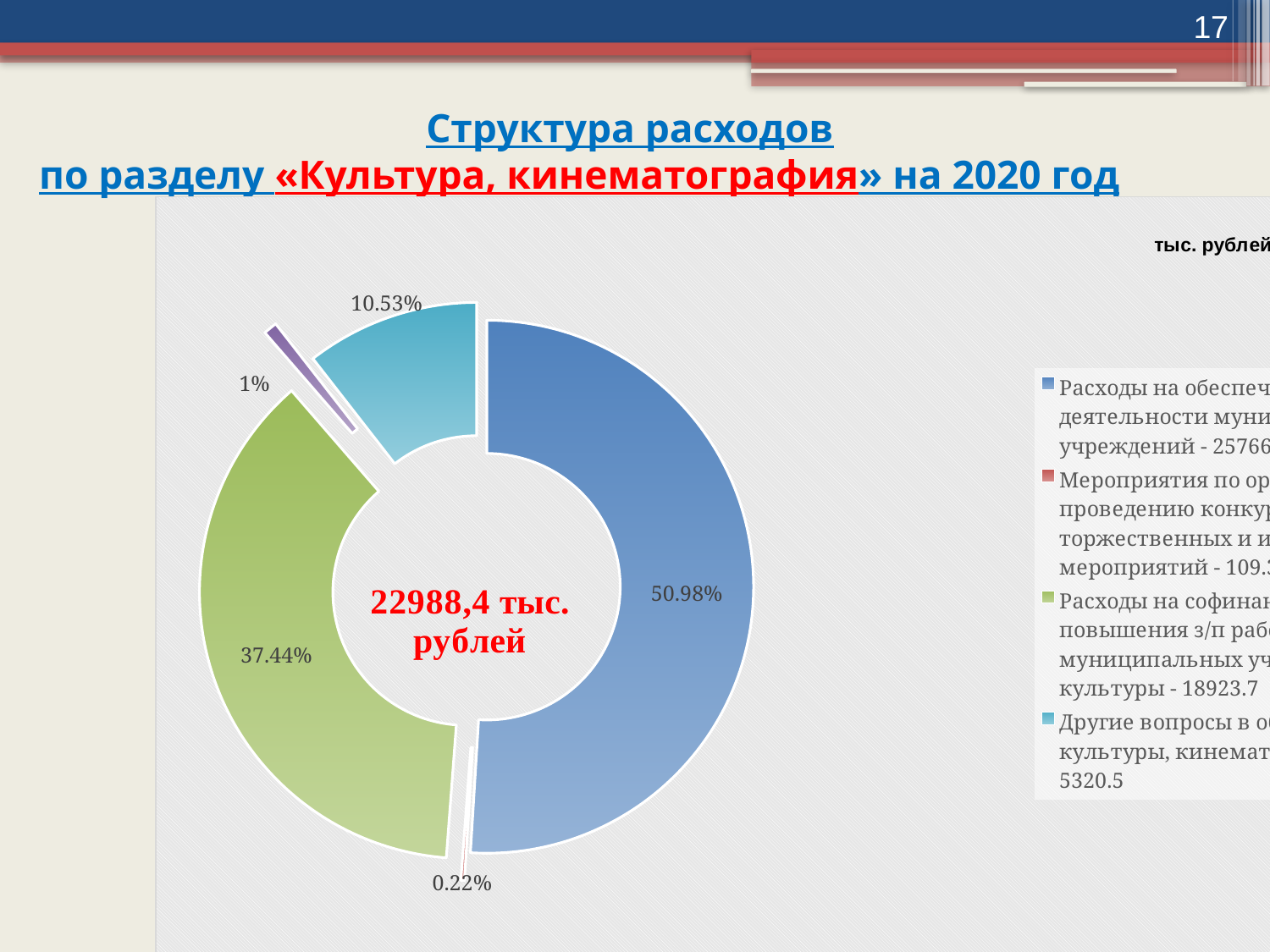
What kind of chart is shown on the slide? doughnut (pie) chart Which slice is larger, the green one or the light blue (teal) one? the green one (37.44%) What total amount is written in the centre of the doughnut chart? 22988,4 тыс. рублей What percentage is shown for the smallest slice of the doughnut chart? 0.22% What year does the slide title say the expenditure structure is for? 2020 What percentage is shown for the largest slice of the doughnut chart? 50.98% What percentage is shown for the purple slice of the chart? 1% What is the difference in percentage points between the 37.44% slice and the 10.53% slice? 26.91 What is the difference in percentage points between the 50.98% slice and the 37.44% slice? 13.54 How many slices with percentage labels does the doughnut chart have? 5 What percentage is shown for the green slice of the chart? 37.44% What percentage is shown for the light blue (teal) slice of the chart? 10.53%